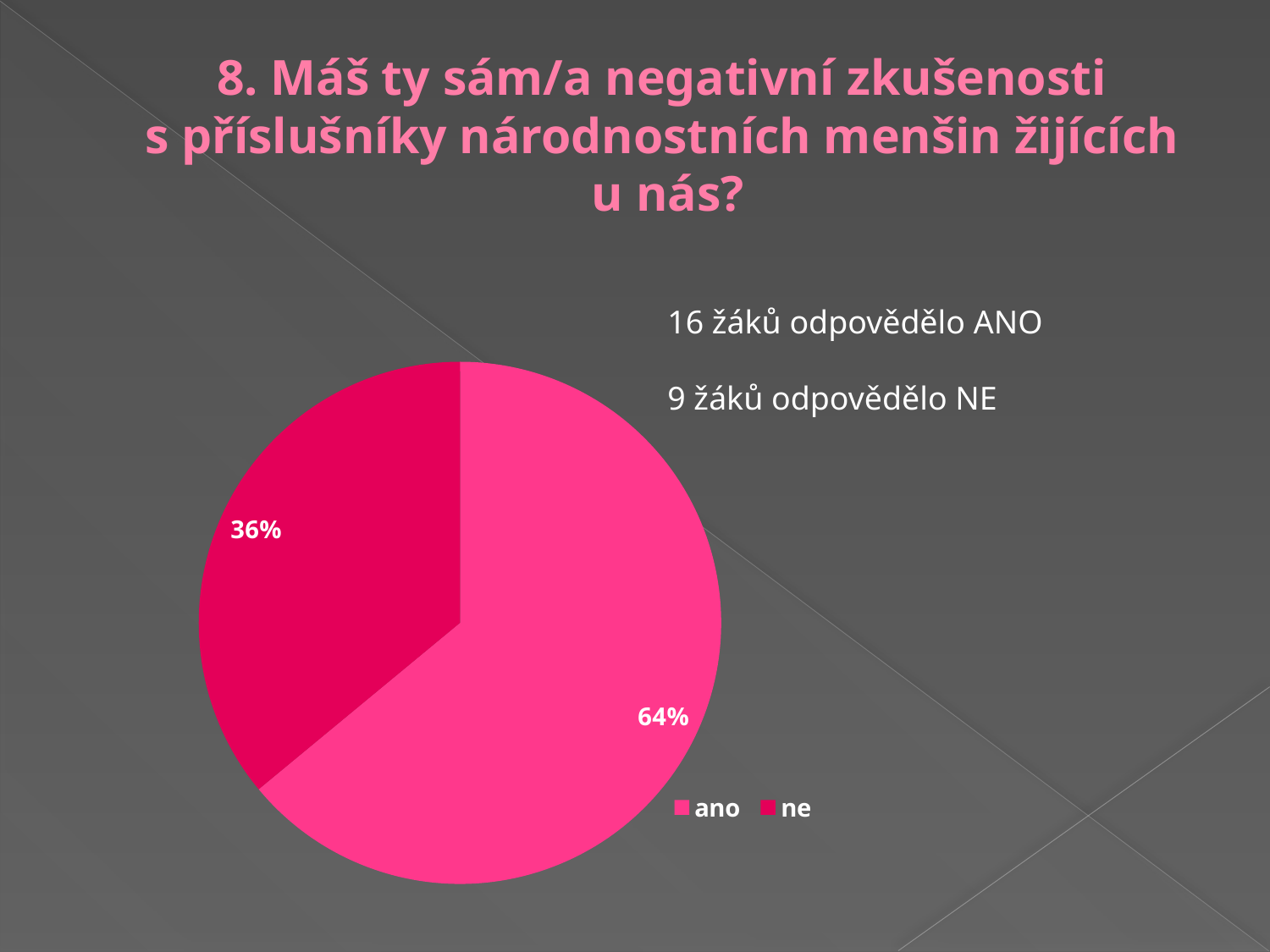
What is the difference in percentage points between the "ano" and "ne" slices? 28 What kind of chart is shown on the slide? pie chart What percentage of the pie is labelled for the "ne" slice? 36% Which slice is larger, "ano" or "ne"? ano How many slices does the pie chart have? 2 Which slice of the pie is the smallest? ne How many entries does the legend list? 2 What are the two legend entries of the pie chart? ano, ne What percentage of the pie is labelled for the "ano" slice? 64% Which slice of the pie is the largest? ano According to the text next to the chart, how many pupils answered ANO? 16 What share of the pie does the "ne" slice take? 36%